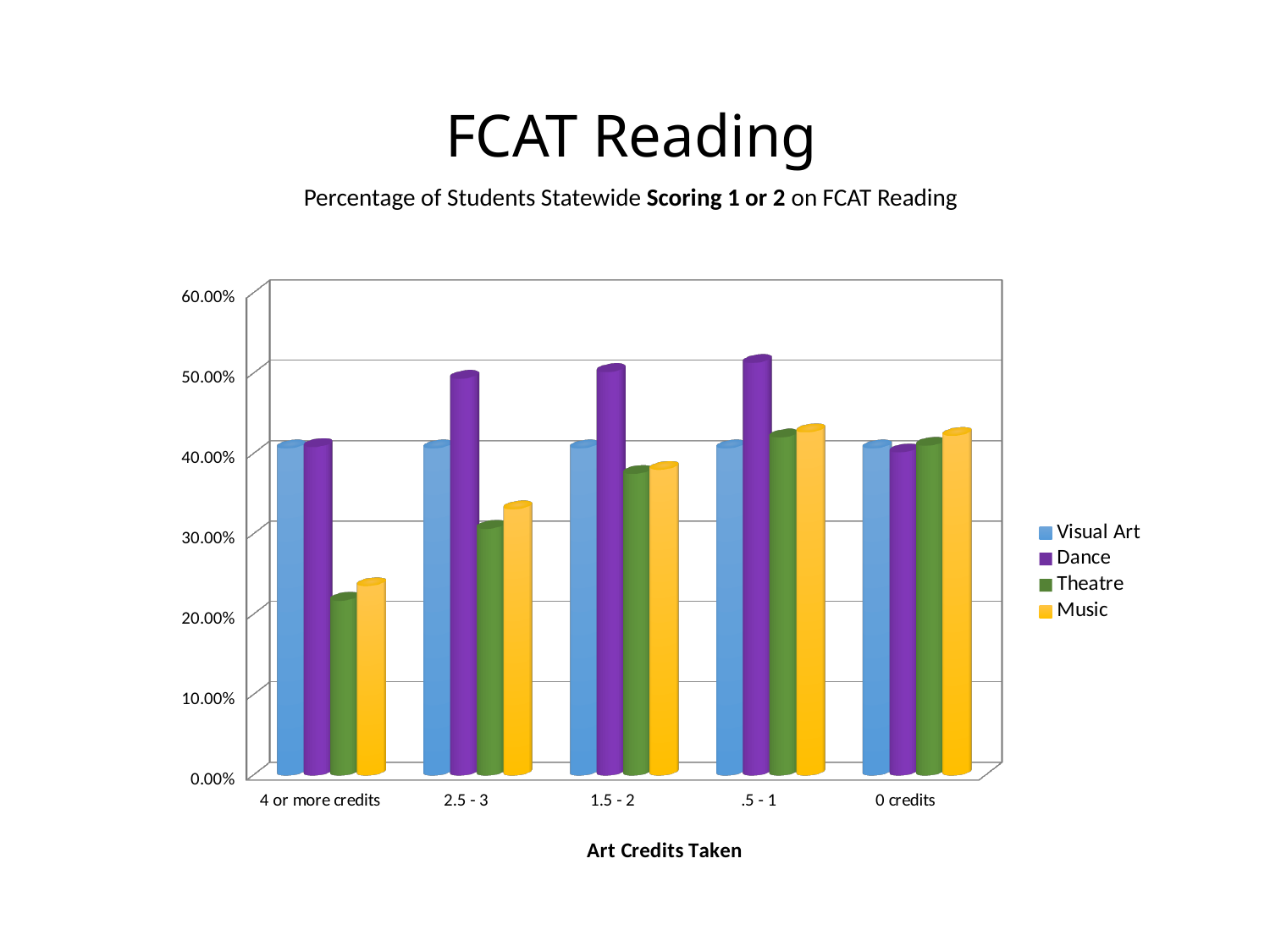
Do the Theatre values rise or fall moving along the x axis from 4 or more credits to 0 credits? rise Which series has the lowest value for the 4 or more credits category? Theatre Which is larger for the 4 or more credits category, Music or Theatre? Music Is the value for Music at 2.5 - 3 credits greater or less than 40.00%? less How many art-credit categories are shown on the x axis? 5 Is the value for Theatre at 4 or more credits greater or less than 30.00%? less What is the title of the x axis? Art Credits Taken Which series has the highest value for the 2.5 - 3 credits category? Dance What kind of chart is shown on the slide? bar chart Which series has the highest value for the .5 - 1 credits category? Dance How many series does the legend list? 4 Is the value for Dance at 1.5 - 2 credits greater or less than 40.00%? greater